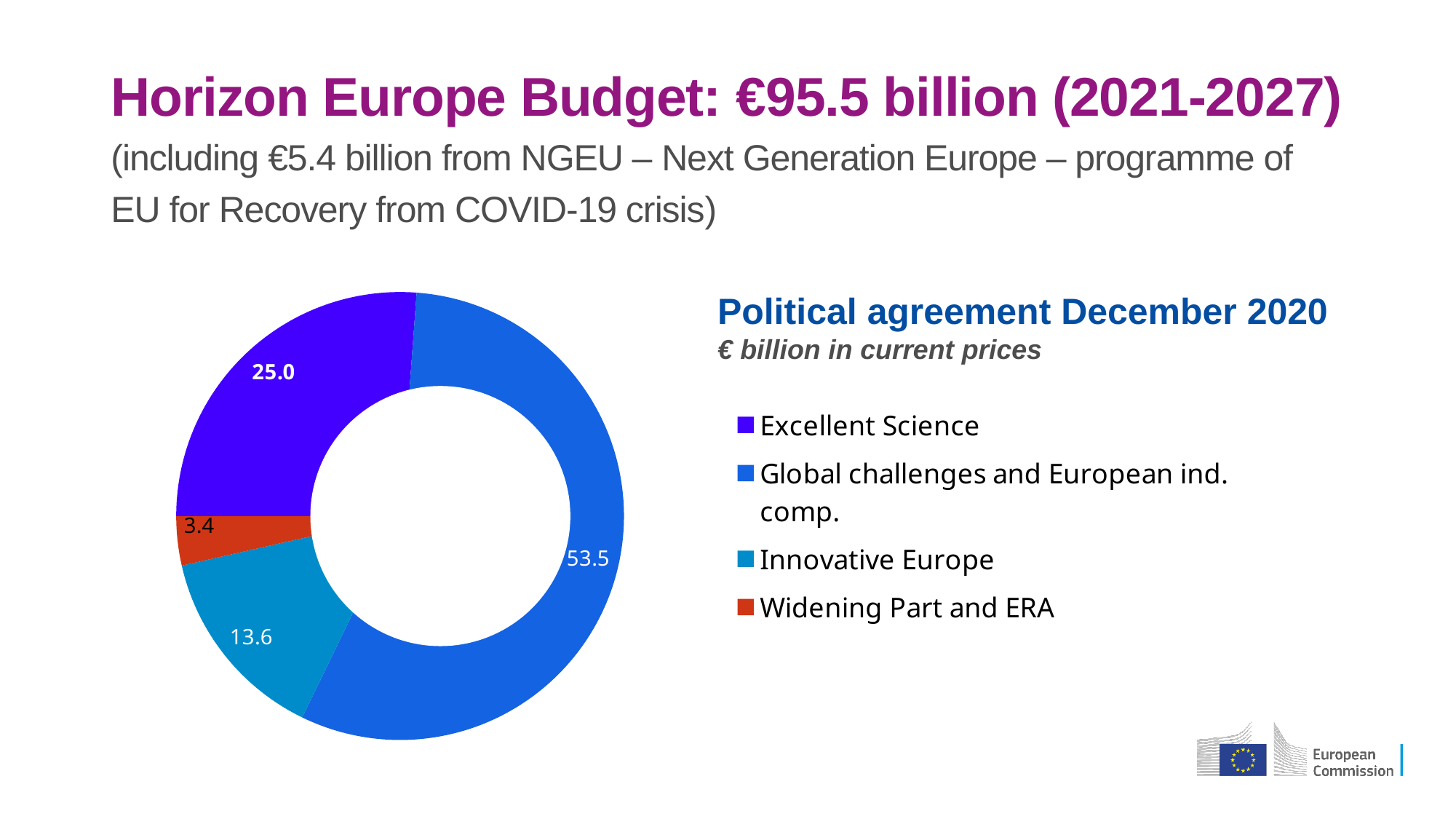
Which category has the largest slice? Global challenges and European ind. comp. What is the value for Widening Part and ERA? 3.4 Which category has the smallest slice? Widening Part and ERA What colour is the slice for Widening Part and ERA? red What is the difference between the values for Innovative Europe and Widening Part and ERA? 10.2 What kind of chart is shown on the slide? pie chart (doughnut) How many categories does the chart show? 4 What is the value for Global challenges and European ind. comp.? 53.5 What is the value for Innovative Europe? 13.6 Which is larger, Excellent Science or Innovative Europe? Excellent Science What is the difference between the values for Global challenges and European ind. comp. and Excellent Science? 28.5 What is the value for Excellent Science? 25.0